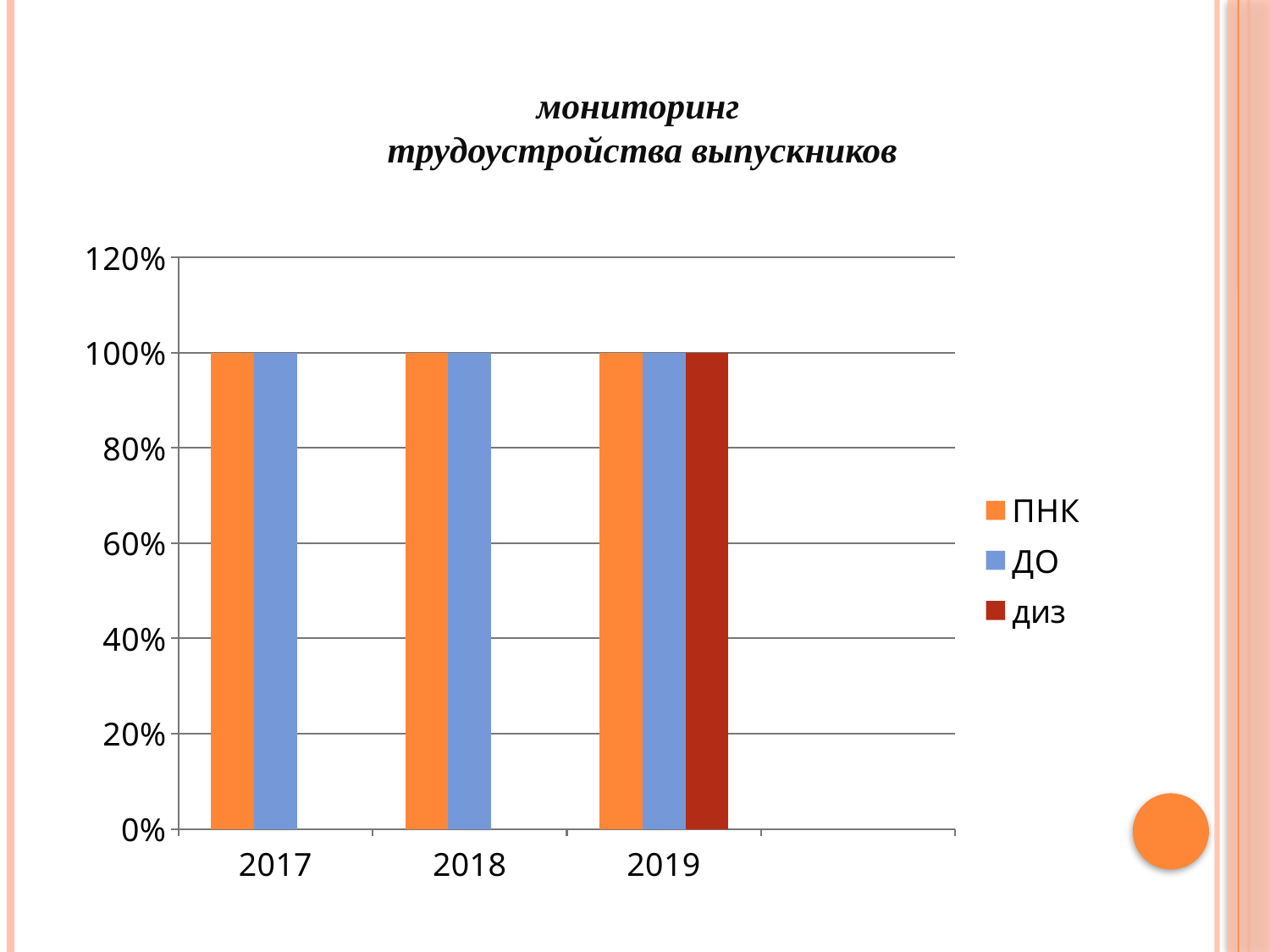
How many series does the legend list? 3 How many years are shown on the x axis? 3 What is the value for ПНК in 2019? 100% What is the value for ПНК in 2017? 100% What colour are the bars for the ПНК series? orange Is the value for ДО in 2017 greater or less than 80%? greater What kind of chart is shown on the slide? bar chart What is the difference between the ПНК value and the ДО value in 2018? 0% What is the value for диз in 2019? 100% Is the value for диз in 2019 greater or less than 60%? greater What is the value for ДО in 2018? 100% Which year is the only one with a bar for the диз series? 2019